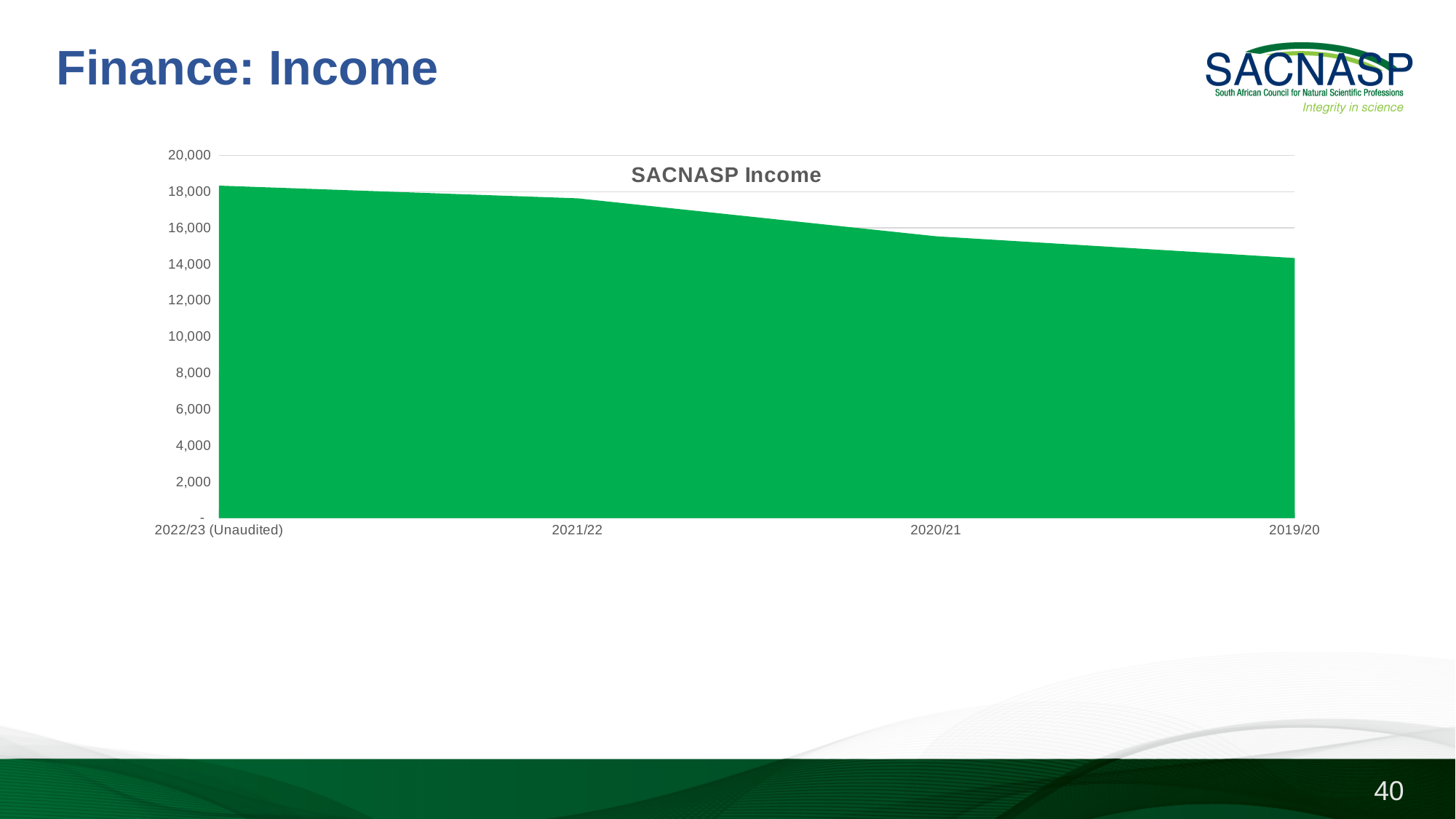
Is the value for 2020/21 greater or less than 14,000? greater Which is larger, the income for 2021/22 or for 2019/20? 2021/22 Which period has the lowest income in the chart? 2019/20 Do the values rise or fall moving from left to right along the x axis? fall What kind of chart is shown on the slide? Area chart Is the value for 2019/20 greater or less than 16,000? less What colour is the filled area in the chart? Green How many periods are shown on the x axis of the chart? 4 What is the title of the chart? SACNASP Income Is the value for 2022/23 (Unaudited) greater or less than 18,000? greater Which period has the highest income in the chart? 2022/23 (Unaudited)